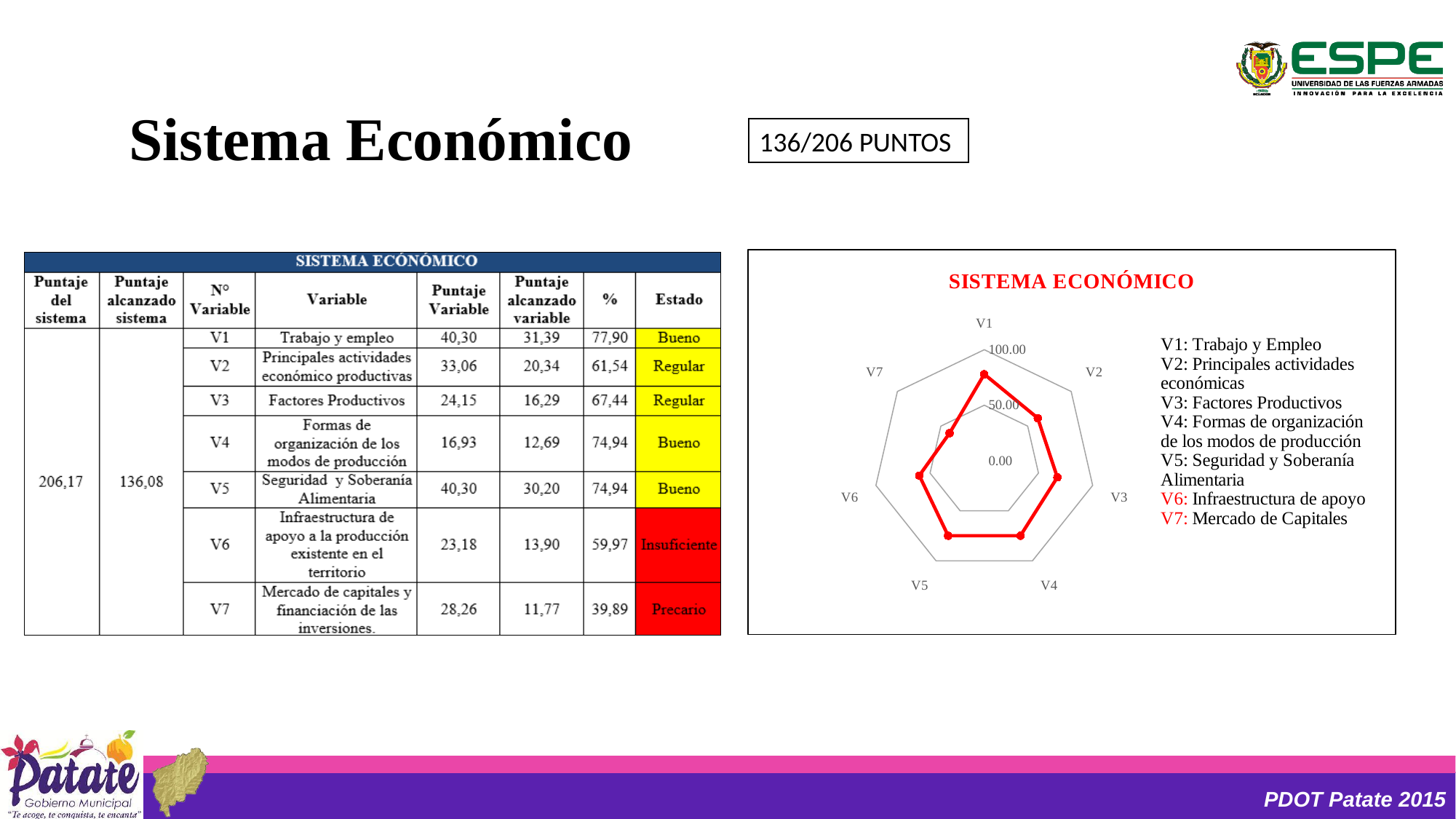
Is the value for V7 on the radar chart greater or less than 50.00? less How many variables (axes) does the radar chart have? 7 What is the title of the radar chart? SISTEMA ECONÓMICO What is the highest value shown on the radar chart's scale? 100.00 Is the value for V1 on the radar chart greater or less than 50.00? greater On the radar chart, which is larger, the value for V5 or the value for V7? V5 What kind of chart is shown on the right of the slide? Radar chart On the radar chart, which is larger, the value for V1 or the value for V7? V1 Is the value for V4 on the radar chart greater or less than 50.00? greater On the radar chart, which is larger, the value for V3 or the value for V7? V3 Which variable has the lowest value on the radar chart? V7